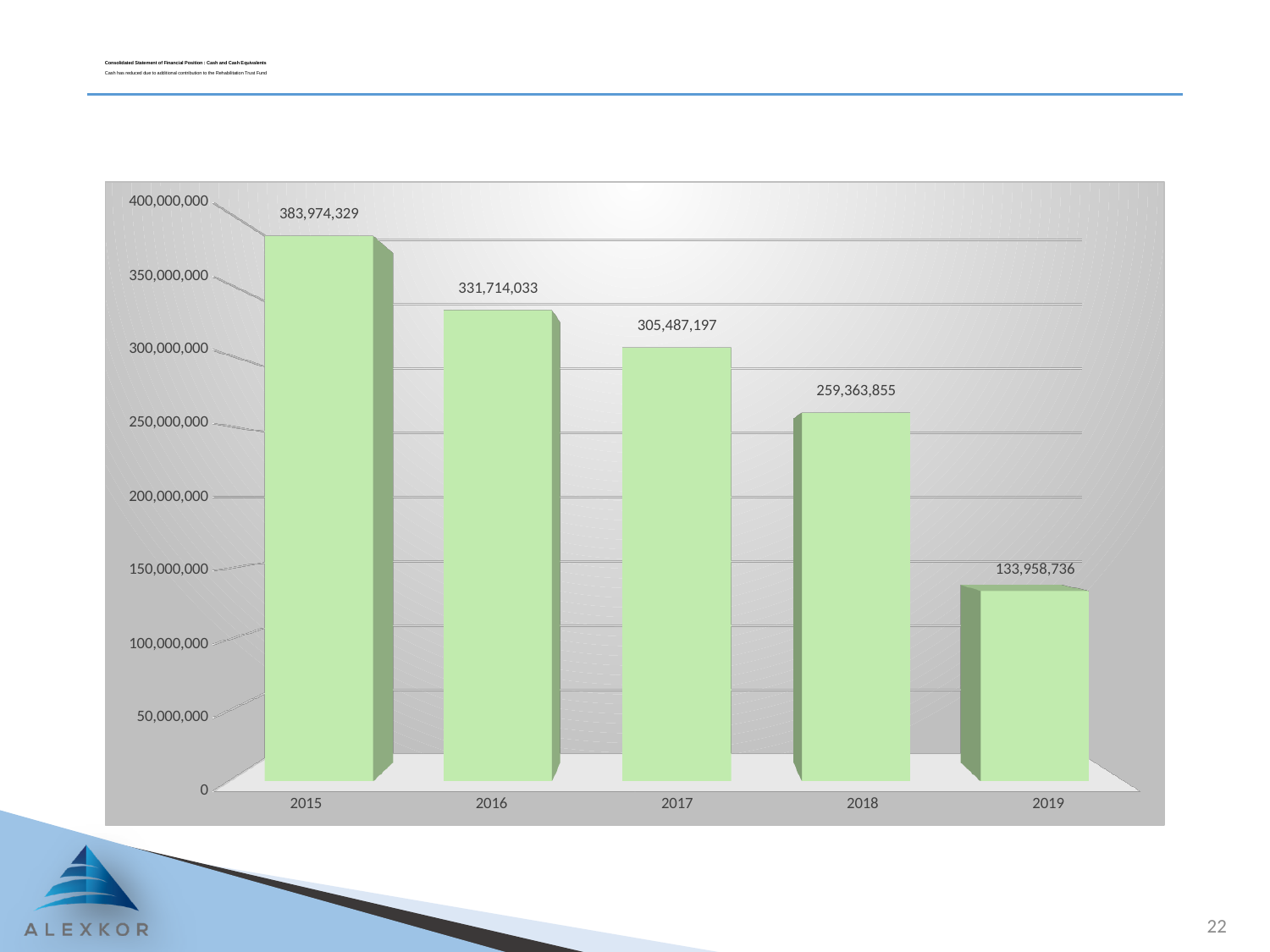
Is the value for 2017 greater or less than 300,000,000? greater What is the value shown for 2015? 383,974,329 What kind of chart is shown on the slide? bar chart How many years are shown on the x axis? 5 Which year has the lowest value? 2019 What is the value shown for 2017? 305,487,197 What is the difference between the values for 2018 and 2019? 125,405,119 Which is larger, the value for 2016 or the value for 2018? 2016 Which year has the highest value? 2015 What is the value shown for 2019? 133,958,736 Do the values rise or fall from 2015 to 2019? fall What is the difference between the values for 2015 and 2016? 52,260,296